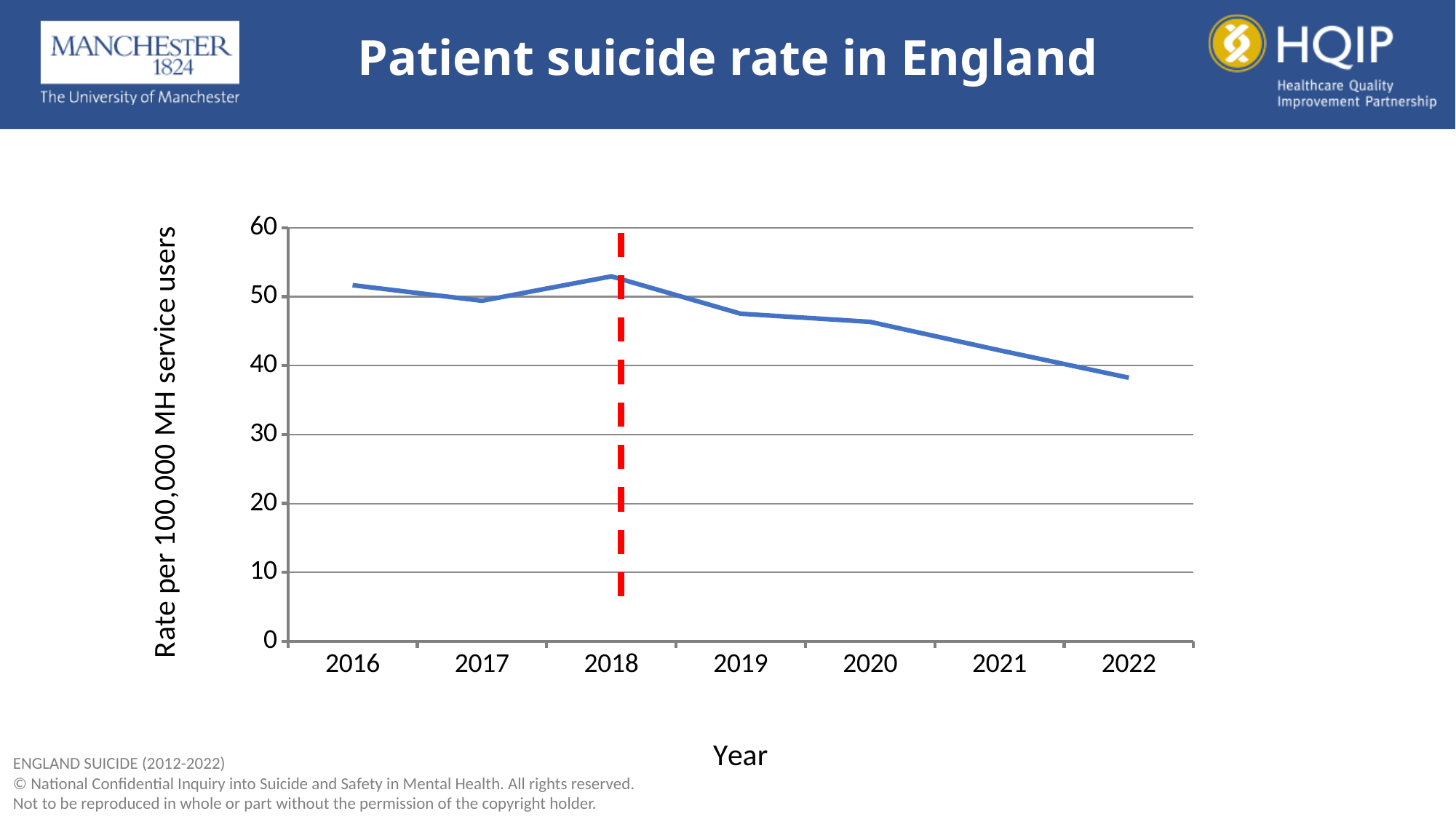
Is the value for 2019 greater or less than 50? less Which year has the larger value, 2016 or 2021? 2016 What kind of chart is shown on the slide? line chart In which year is the patient suicide rate highest? 2018 Which year has the larger value, 2018 or 2022? 2018 What is the label on the y axis? Rate per 100,000 MH service users Is the value for 2021 greater or less than 40? greater Is the value for 2018 greater or less than 50? greater In which year is the patient suicide rate lowest? 2022 How many years are plotted on the x axis? 7 Does the rate rise or fall from 2018 to 2022? fall